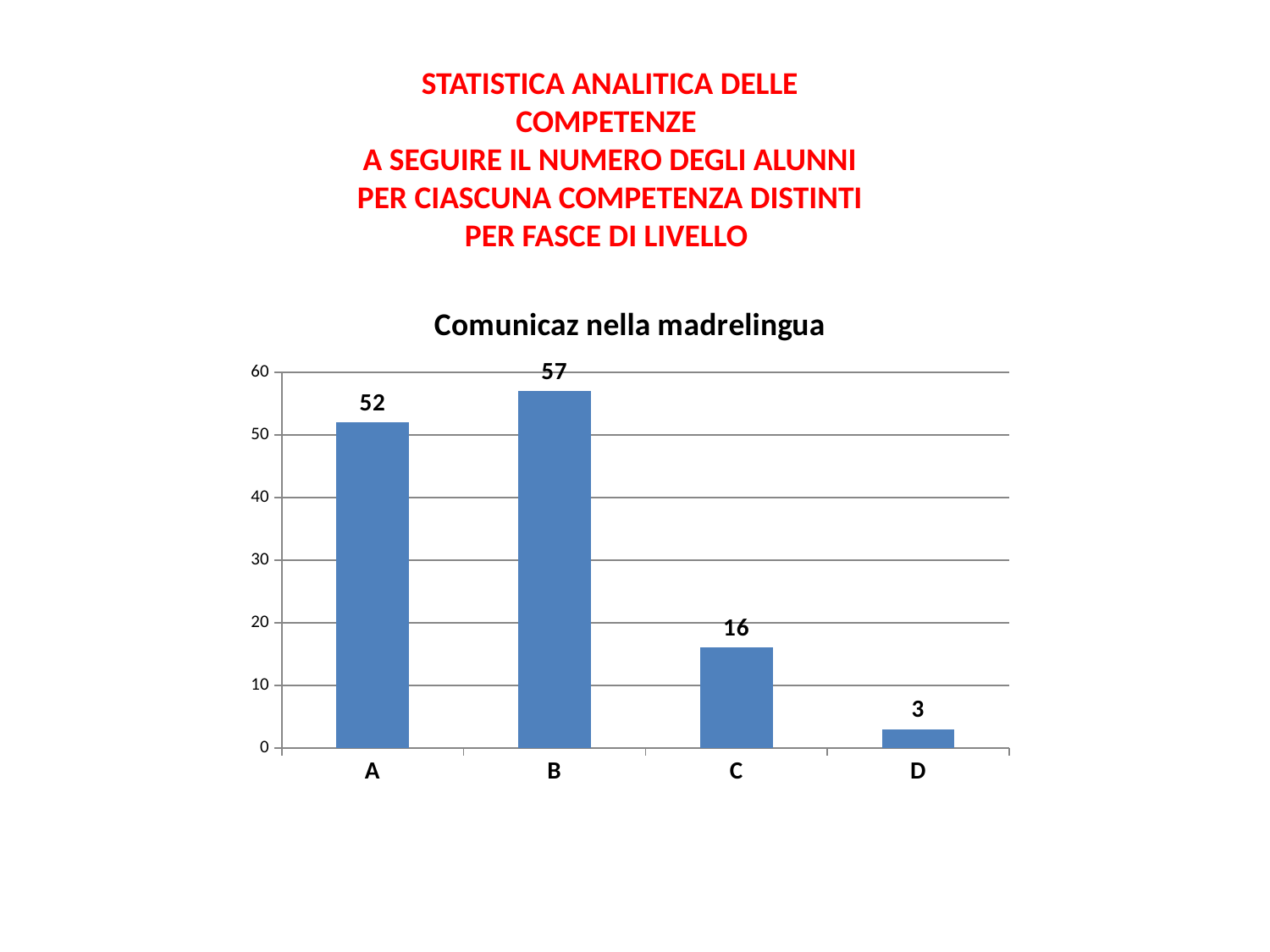
Which category has the lowest value? D What kind of chart is shown? Bar chart What is the value for category B? 57 What is the value for category A? 52 Which category has the highest value? B What is the value for category D? 3 What is the difference between the values for B and A? 5 Which is larger, the value for A or the value for C? A What is the title of the chart? Comunicaz nella madrelingua What is the value for category C? 16 What is the difference between the values for C and D? 13 How many categories are shown on the x axis? 4